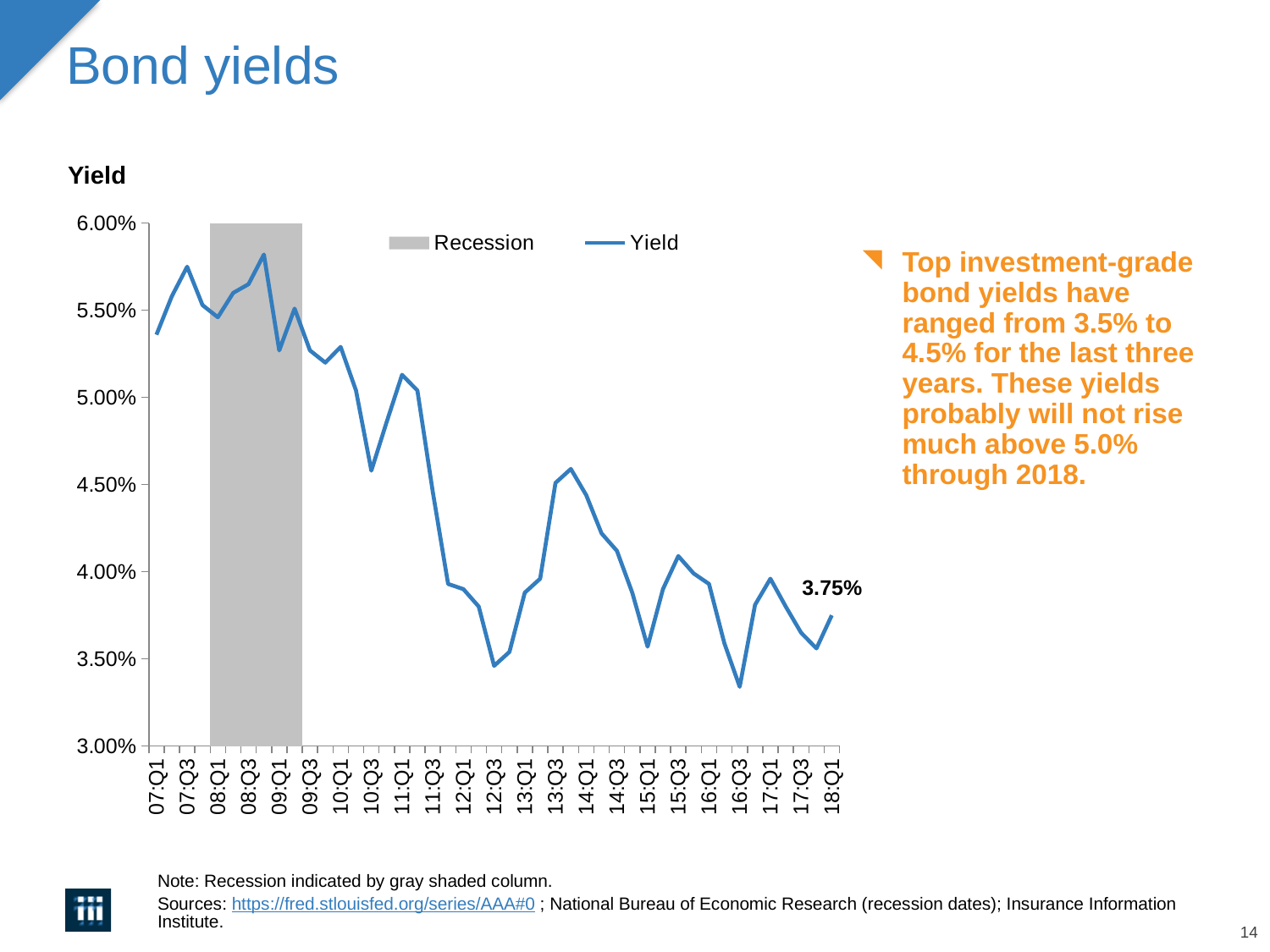
Which is higher, the yield at 07:Q1 or the yield at 18:Q1? 07:Q1 What is the yield value labeled at 18:Q1? 3.75% At which quarter is the yield lowest? 16:Q3 What type of chart is shown on the slide? line chart Which is higher, the yield at 09:Q1 or the yield at 12:Q1? 09:Q1 What is the title shown above the chart? Yield Is the yield at 08:Q3 greater or less than 5.50%? greater Is the yield at 16:Q3 greater or less than 3.50%? less Is the yield at 07:Q1 greater or less than 5.00%? greater Overall, do yields rise or fall from 07:Q1 to 18:Q1? fall How many entries does the chart legend list? 2 What does the gray shaded column on the chart indicate? Recession